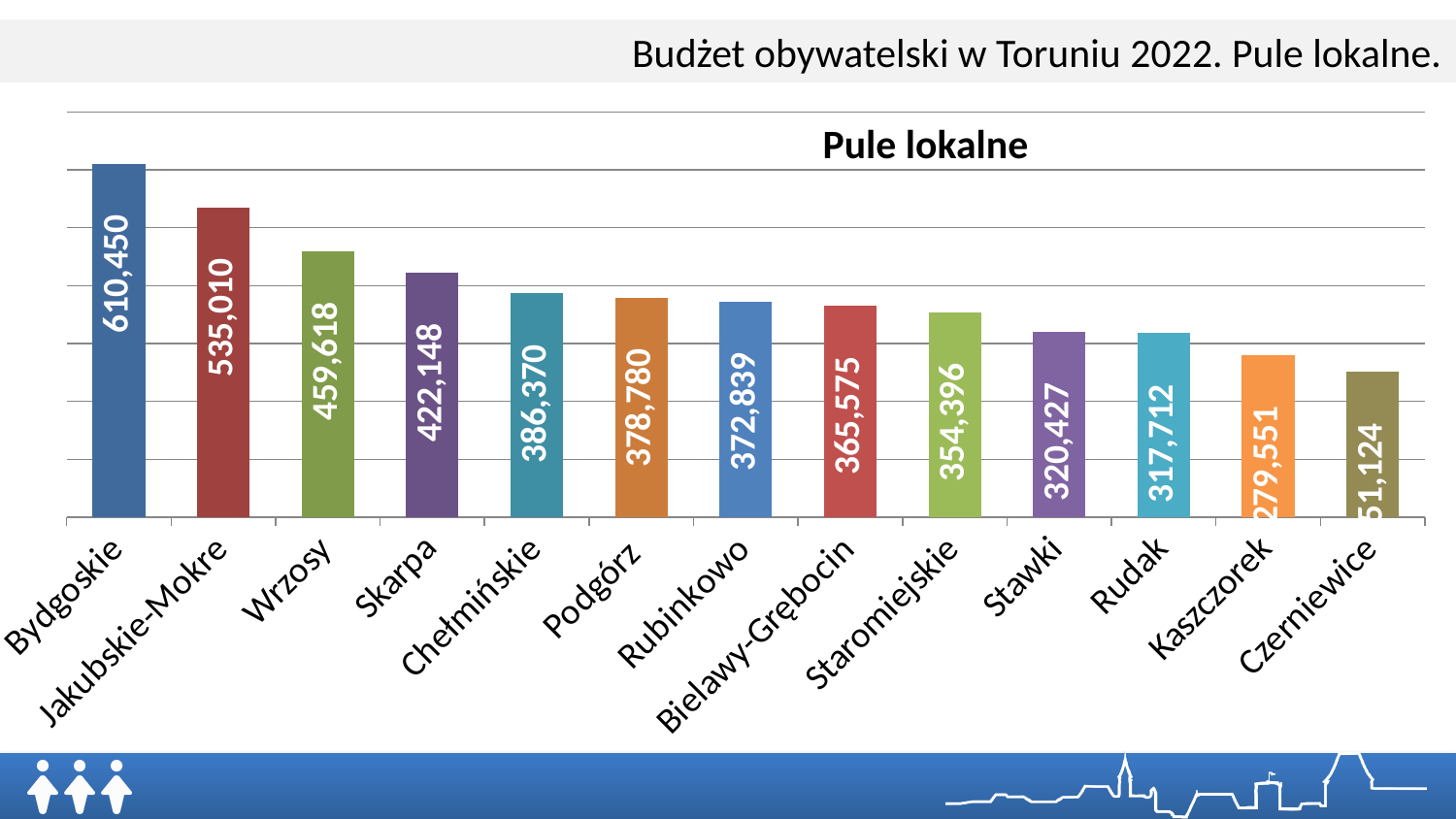
What is the title of the chart? Pule lokalne How many categories are shown in the chart? 13 What is the value for Skarpa? 422,148 What is the difference between the values for Bydgoskie and Jakubskie-Mokre? 75,440 Which category has the lowest value? Czerniewice Which is larger, the value for Chełmińskie or the value for Staromiejskie? Chełmińskie What is the value for Bydgoskie? 610,450 What is the value for Kaszczorek? 279,551 What kind of chart is shown on the slide? Bar chart Which category has the highest value? Bydgoskie What is the value for Rubinkowo? 372,839 What is the difference between the values for Wrzosy and Skarpa? 37,470